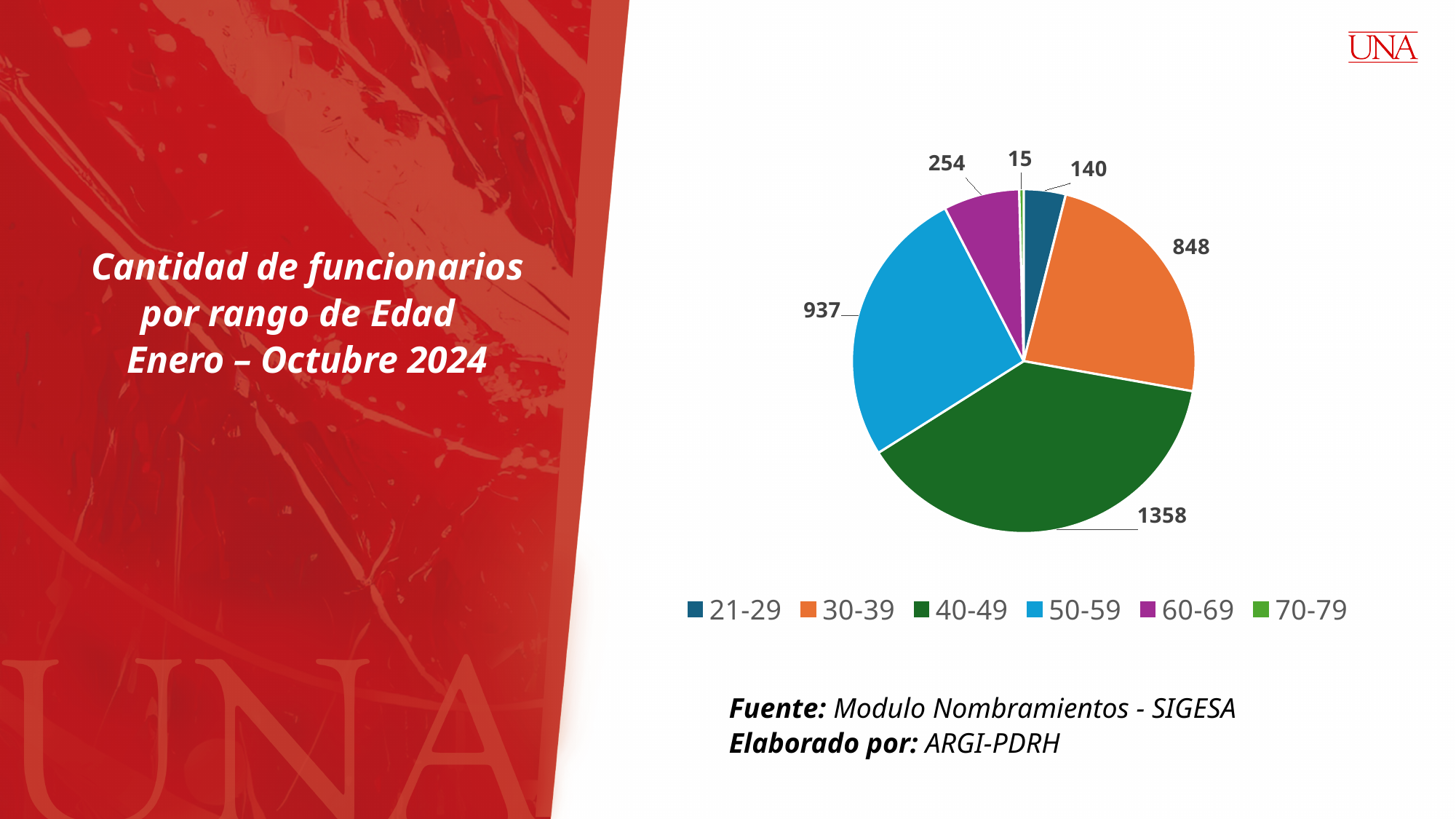
What is the value for the 21-29 age range? 140 Which age range has the smallest number of funcionarios? 70-79 Which is larger, the value for 30-39 or the value for 60-69? 30-39 What is the value for the 50-59 age range? 937 What colour represents the 50-59 age range in the legend? Light blue What is the value for the 70-79 age range? 15 How many age ranges are shown in the pie chart? 6 What is the difference between the 40-49 and 50-59 age ranges? 421 How many funcionarios are in the 40-49 age range? 1358 What is the difference between the 30-39 and 21-29 age ranges? 708 What kind of chart is shown on the slide? Pie chart Which age range has the largest number of funcionarios? 40-49